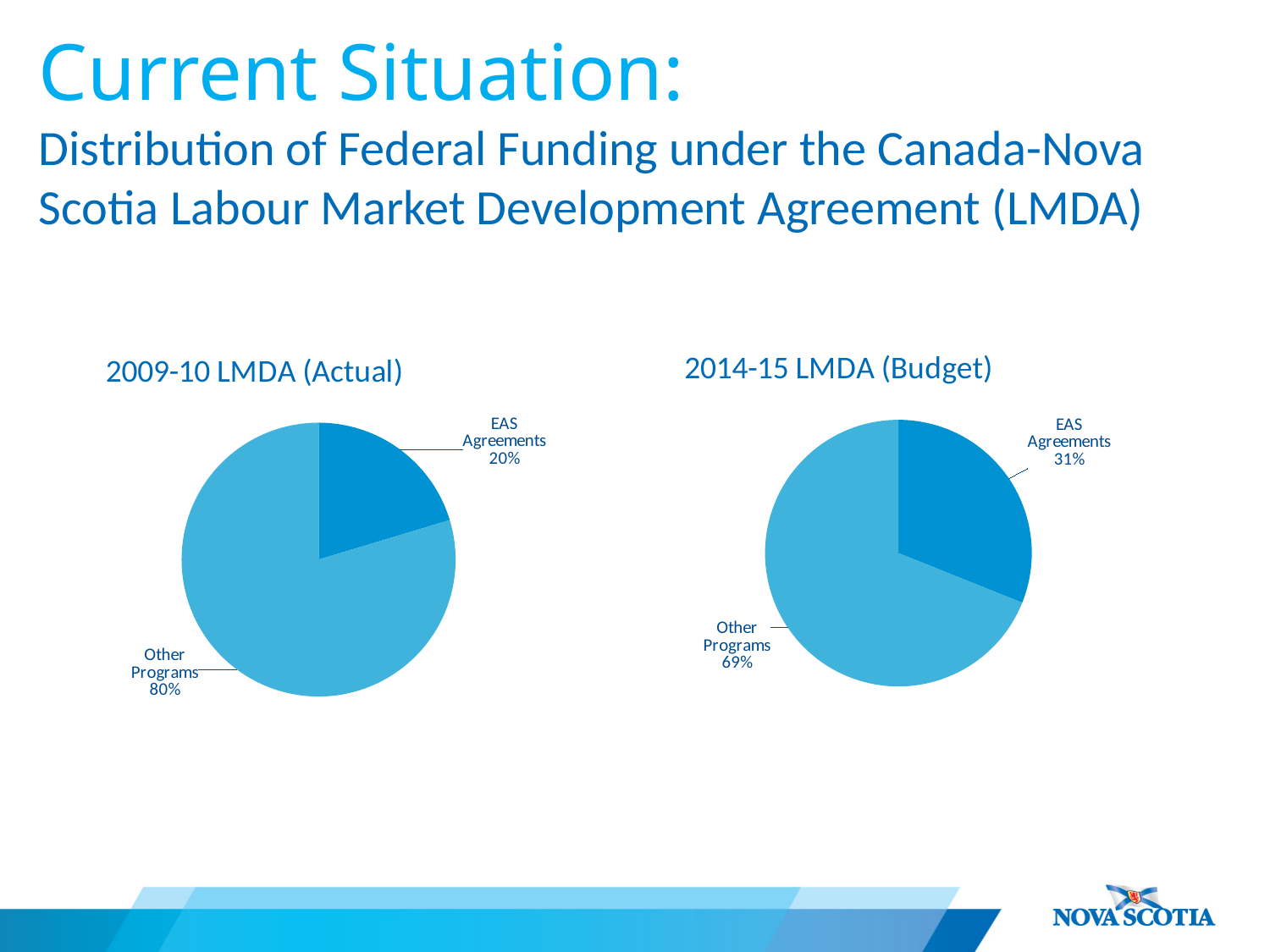
How many charts are shown on the slide? 2 In the 2014-15 LMDA (Budget) chart, what share of funding goes to Other Programs? 69% How many slices does the 2014-15 LMDA (Budget) pie chart have? 2 What is the title of the chart on the right side of the slide? 2014-15 LMDA (Budget) In the 2014-15 LMDA (Budget) chart, which category has the smallest share? EAS Agreements In the 2014-15 LMDA (Budget) chart, what share of funding goes to EAS Agreements? 31% In the 2014-15 LMDA (Budget) chart, what is the difference between the Other Programs share and the EAS Agreements share? 38% In the 2009-10 LMDA (Actual) chart, what share of funding goes to EAS Agreements? 20% What type of chart is the 2009-10 LMDA (Actual) chart? Pie chart In the 2009-10 LMDA (Actual) chart, what share of funding goes to Other Programs? 80% Is the EAS Agreements share larger in the 2009-10 LMDA (Actual) chart or the 2014-15 LMDA (Budget) chart? 2014-15 LMDA (Budget) In the 2009-10 LMDA (Actual) chart, which category has the largest share? Other Programs